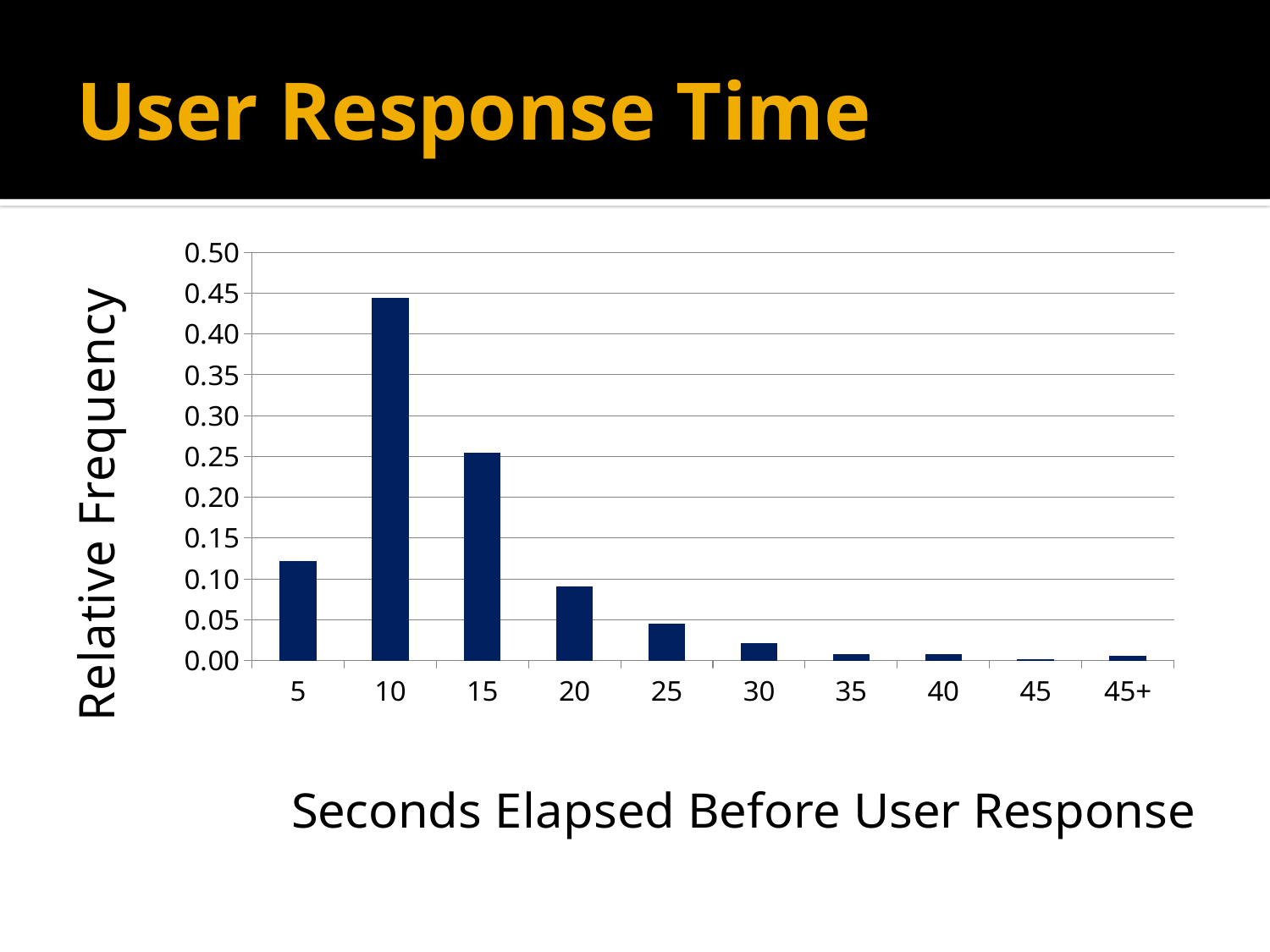
Is the value for 30 greater or less than 0.05? less Is the value for 5 greater or less than 0.10? greater What is the label of the y axis? Relative Frequency How many categories are shown on the x axis? 10 Is the value for 10 greater or less than 0.40? greater Which has a higher relative frequency, 5 or 20? 5 Do the values rise or fall along the x axis from 10 to 45? fall Which has a higher relative frequency, 10 or 15? 10 What kind of chart is shown on the slide? bar chart Which category has the highest relative frequency? 10